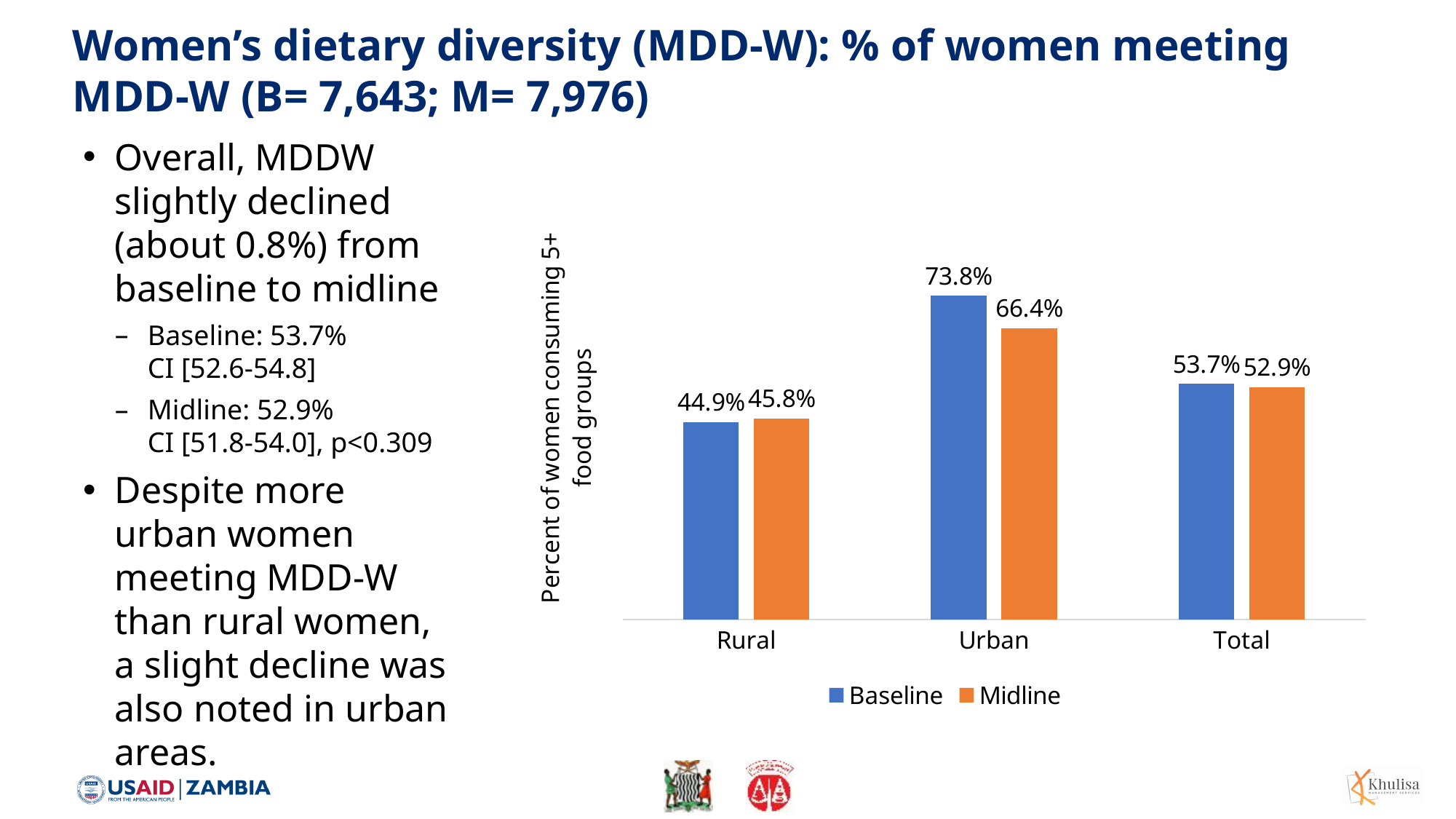
What is the Baseline value for Total? 53.7% What is the Midline value for Urban? 66.4% What is the difference between the Baseline and Midline values for Urban? 7.4% Which category has the highest Baseline value? Urban How many series does the legend list? 2 Which category has the lowest Midline value? Rural Which is larger for Rural, the Baseline value or the Midline value? Midline What is the difference between the Urban and Rural Baseline values? 28.9% What is the Baseline value for Rural? 44.9% How many categories are shown on the x axis? 3 What is the Midline value for Rural? 45.8% What kind of chart is shown on the slide? Bar chart